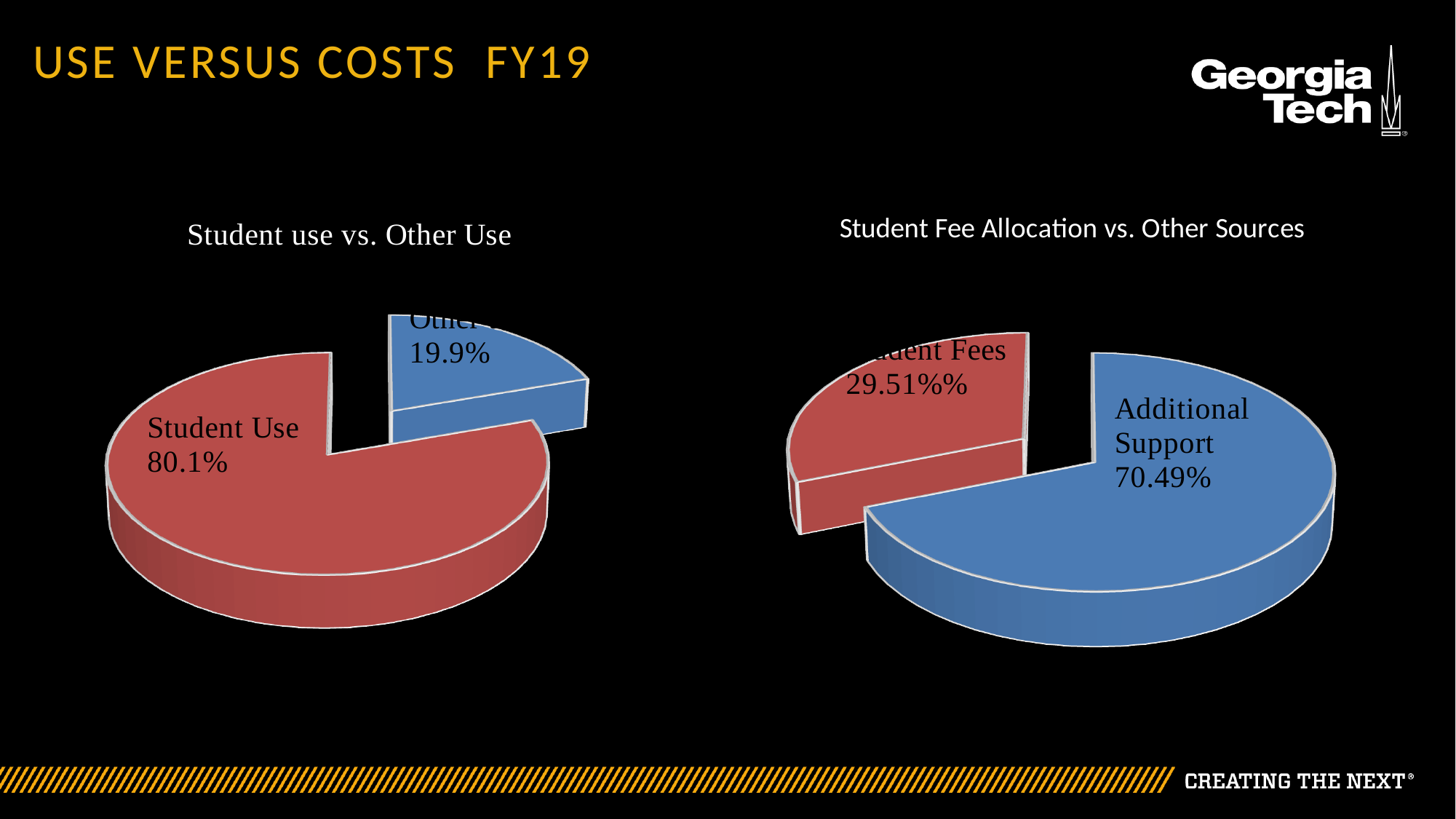
In the 'Student Fee Allocation vs. Other Sources' chart, what share is Additional Support? 70.49% In the 'Student Fee Allocation vs. Other Sources' chart, how many percentage points larger is Additional Support than Student Fees? 40.98 How many charts are on the slide? 2 How many slices does the 'Student Fee Allocation vs. Other Sources' chart have? 2 In the 'Student use vs. Other Use' chart, what share is Student Use? 80.1% In the 'Student use vs. Other Use' chart, what share is Other? 19.9% In the 'Student Fee Allocation vs. Other Sources' chart, which is larger, Student Fees or Additional Support? Additional Support In the 'Student use vs. Other Use' chart, what colour is the Student Use slice? Red In the 'Student use vs. Other Use' chart, which slice is the largest? Student Use In the 'Student use vs. Other Use' chart, how many percentage points larger is Student Use than Other? 60.2 What kind of chart is the 'Student use vs. Other Use' chart? Pie chart In the 'Student Fee Allocation vs. Other Sources' chart, which slice is the smallest? Student Fees